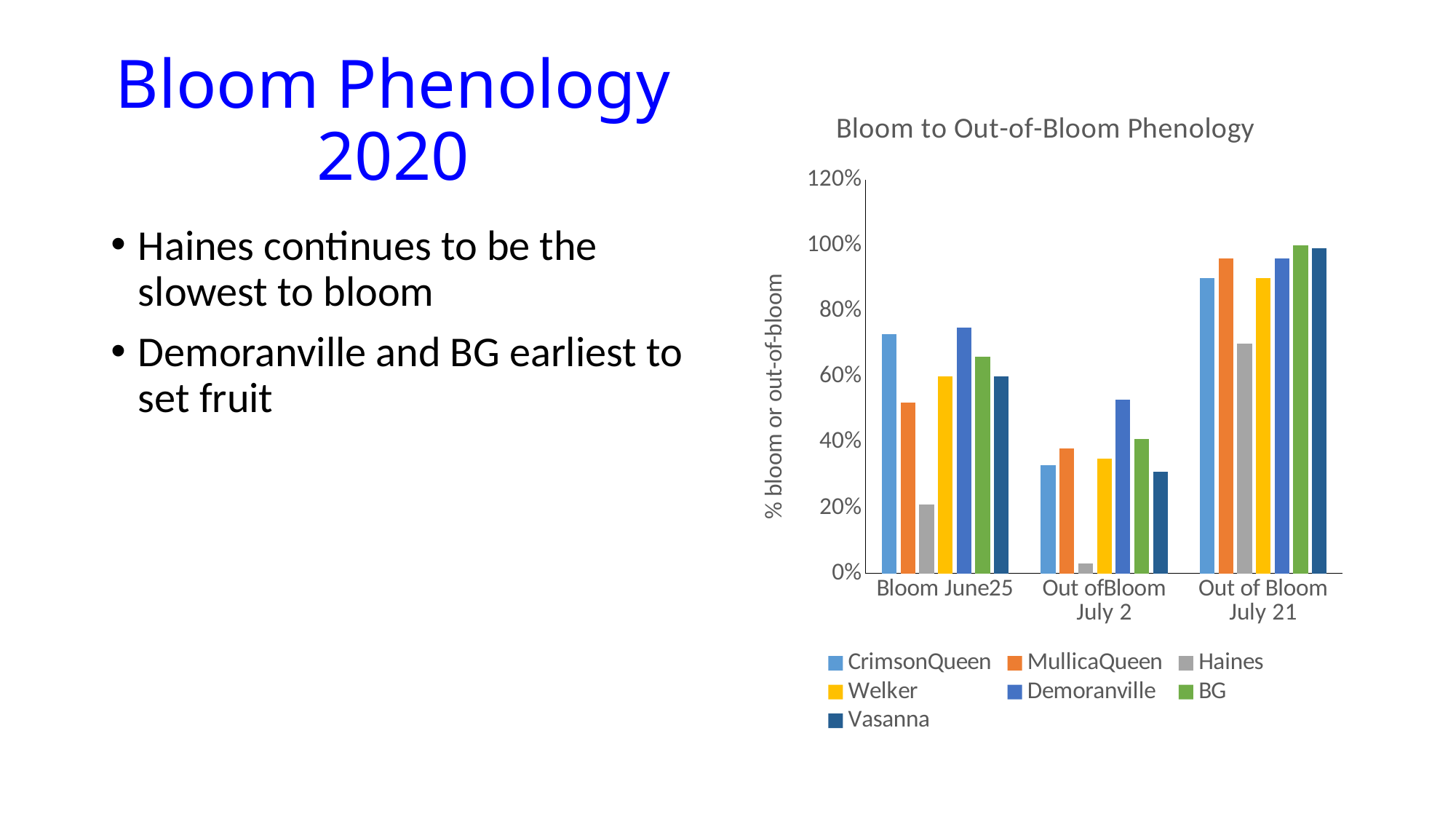
At Bloom June25, which is larger: CrimsonQueen or MullicaQueen? CrimsonQueen Is the value for Haines at Out of Bloom July 21 greater or less than 80%? less Is the value for Haines at Bloom June25 greater or less than 40%? less Which variety has the lowest value for Out of Bloom July 2? Haines Is the value for Demoranville at Out of Bloom July 2 greater or less than 40%? greater Which variety has the lowest value for Out of Bloom July 21? Haines How many categories are shown on the x axis of the chart? 3 What is the title of the chart? Bloom to Out-of-Bloom Phenology Which variety has the lowest value for Bloom June25? Haines How many series does the legend of the chart list? 7 Which variety has the highest value for Out of Bloom July 2? Demoranville What kind of chart is shown on the slide? bar chart